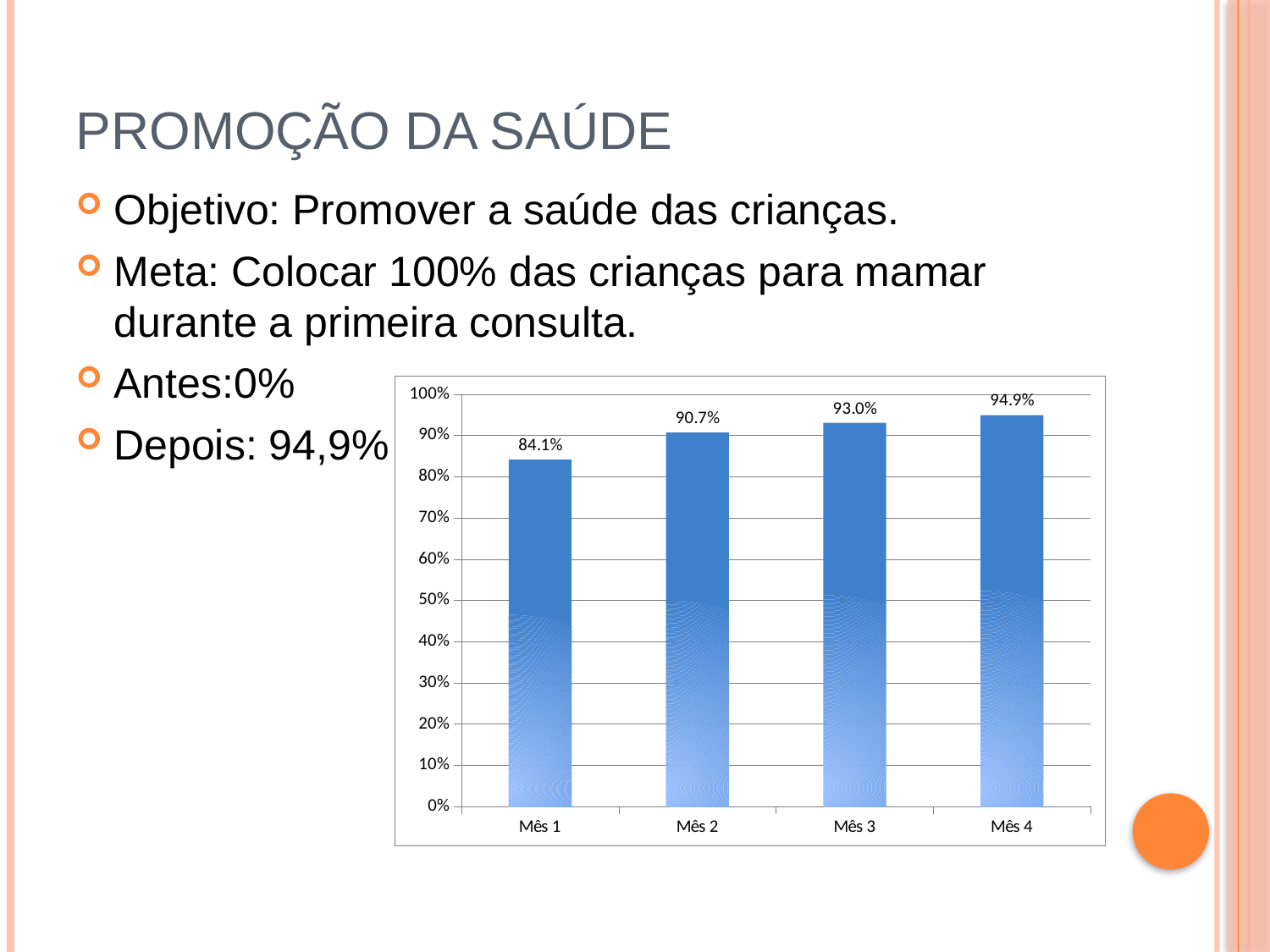
Do the values rise or fall from Mês 1 to Mês 4? rise What is the difference between the values for Mês 4 and Mês 1? 10.8% What is the value for Mês 4? 94.9% Which is larger, the value for Mês 2 or the value for Mês 3? Mês 3 What is the value for Mês 1? 84.1% Is the value for Mês 1 greater or less than 90%? less What kind of chart is shown on the slide? bar chart What is the value for Mês 3? 93.0% What is the value for Mês 2? 90.7% How many months are shown on the x axis? 4 Which month has the highest value? Mês 4 Which month has the lowest value? Mês 1